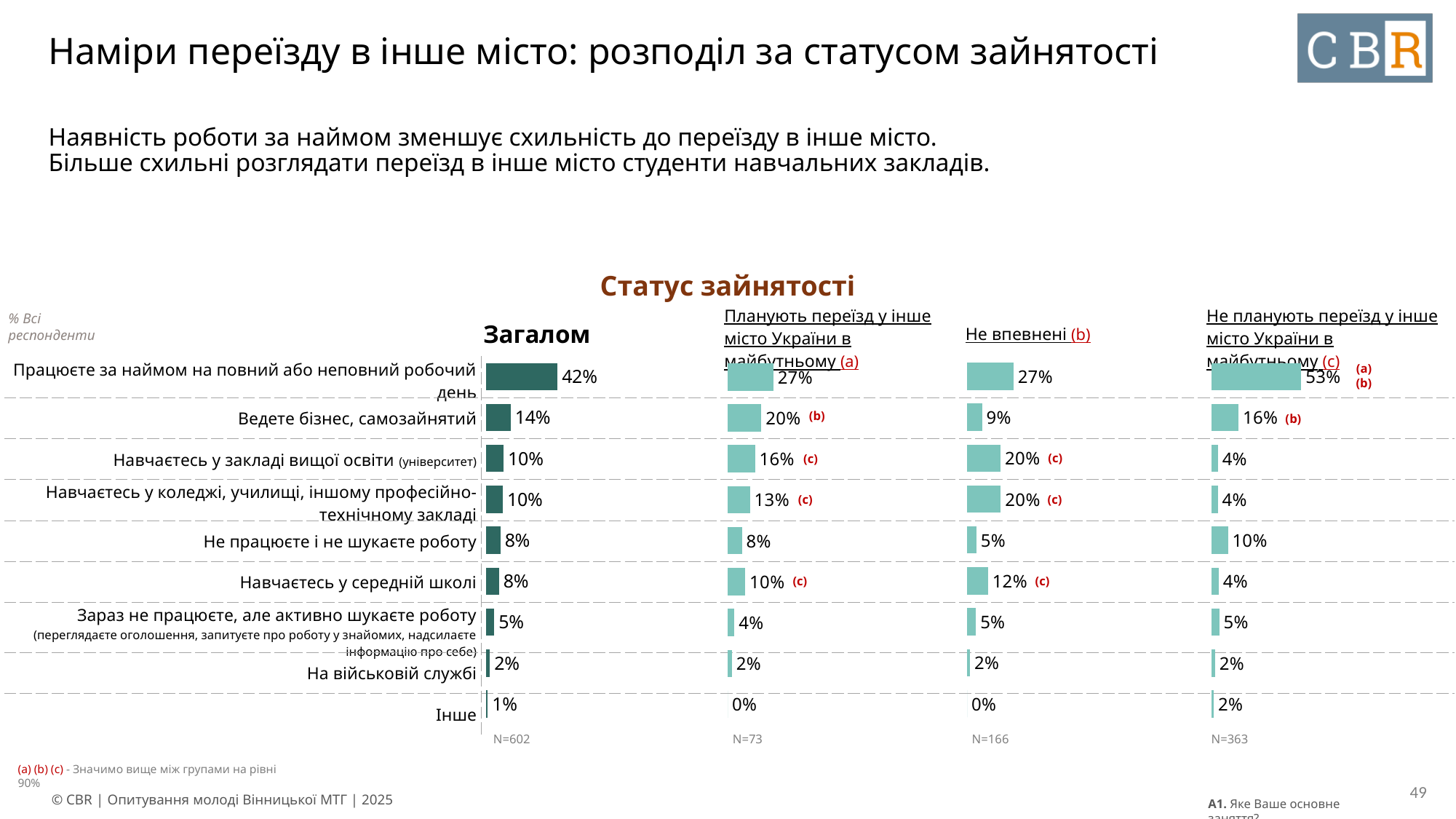
What is the sample size (N) shown under the "Не впевнені (b)" chart? N=166 In the "Не планують переїзд у інше місто України в майбутньому (c)" chart, what is the value for "Працюєте за наймом на повний або неповний робочий день"? 53% In the "Загалом" chart, what is the value for "Працюєте за наймом на повний або неповний робочий день"? 42% In the "Не впевнені (b)" chart, what is the value for "Не працюєте і не шукаєте роботу"? 5% Which is larger: the value for "Навчаєтесь у закладі вищої освіти (університет)" in the "Планують переїзд у інше місто України в майбутньому (a)" chart or in the "Не планують переїзд у інше місто України в майбутньому (c)" chart? Планують переїзд у інше місто України в майбутньому (a) How many categories are shown in the "Загалом" chart? 9 In the "Планують переїзд у інше місто України в майбутньому (a)" chart, what is the value for "Ведете бізнес, самозайнятий"? 20% In the "Не впевнені (b)" chart, what is the value for "Навчаєтесь у закладі вищої освіти (університет)"? 20% What kind of chart is the "Загалом" chart? Bar chart In the "Загалом" chart, which category has the highest value? Працюєте за наймом на повний або неповний робочий день In the "Загалом" chart, which category has the lowest value? Інше What is the difference between the value for "Працюєте за наймом на повний або неповний робочий день" in the "Не планують переїзд у інше місто України в майбутньому (c)" chart and in the "Планують переїзд у інше місто України в майбутньому (a)" chart? 26%